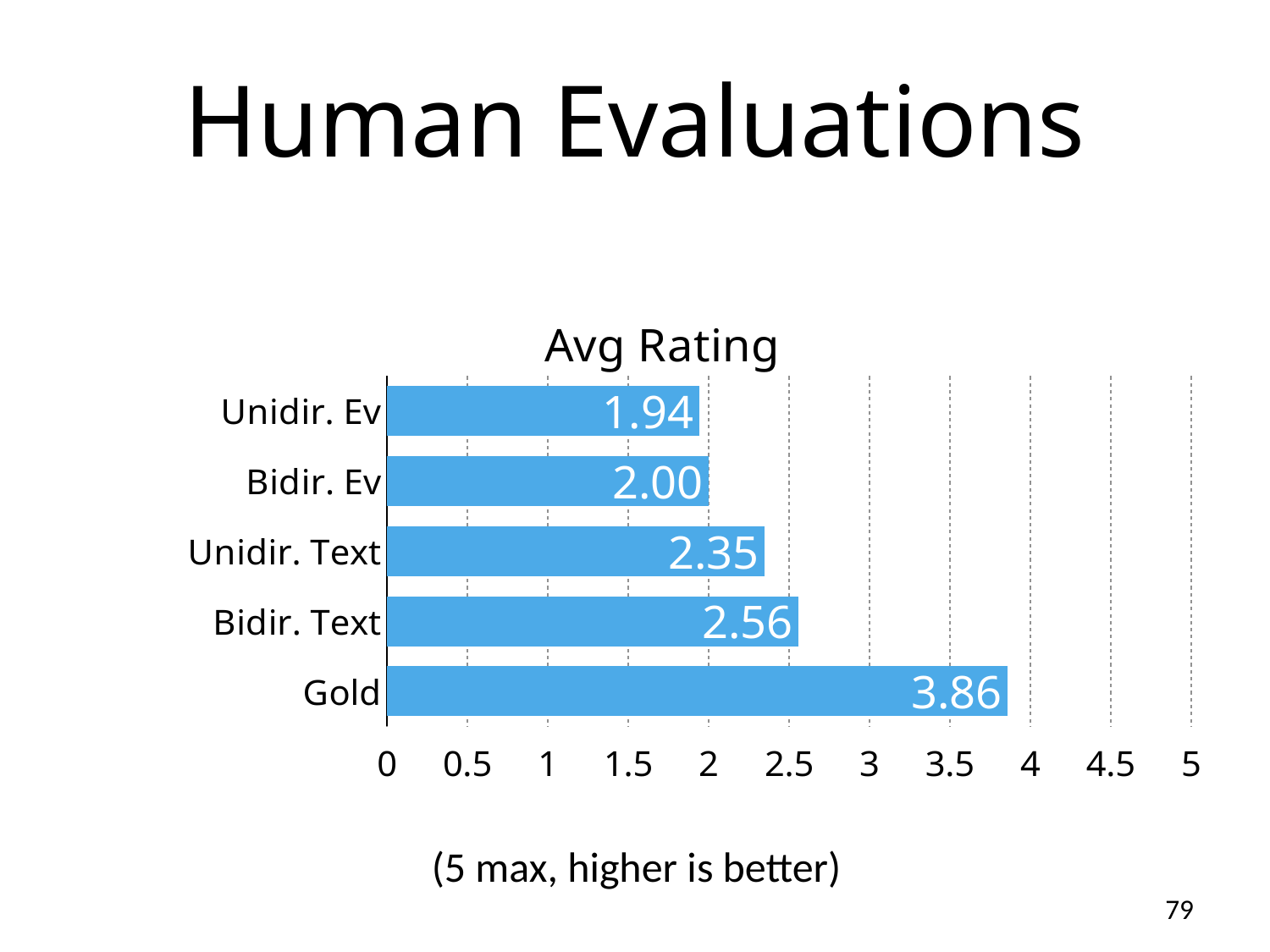
What is the difference between the Avg Rating for Gold and for Bidir. Text? 1.30 What is the Avg Rating for Gold? 3.86 Which category has the highest Avg Rating? Gold Which has a higher Avg Rating, Unidir. Text or Bidir. Text? Bidir. Text Is the Avg Rating for Gold greater or less than 3.5? greater What is the Avg Rating for Unidir. Ev? 1.94 Which category has the lowest Avg Rating? Unidir. Ev What kind of chart is shown on the slide? bar chart What is the Avg Rating for Bidir. Ev? 2.00 What is the Avg Rating for Bidir. Text? 2.56 What is the difference between the Avg Rating for Bidir. Text and for Unidir. Text? 0.21 How many categories are shown in the chart? 5